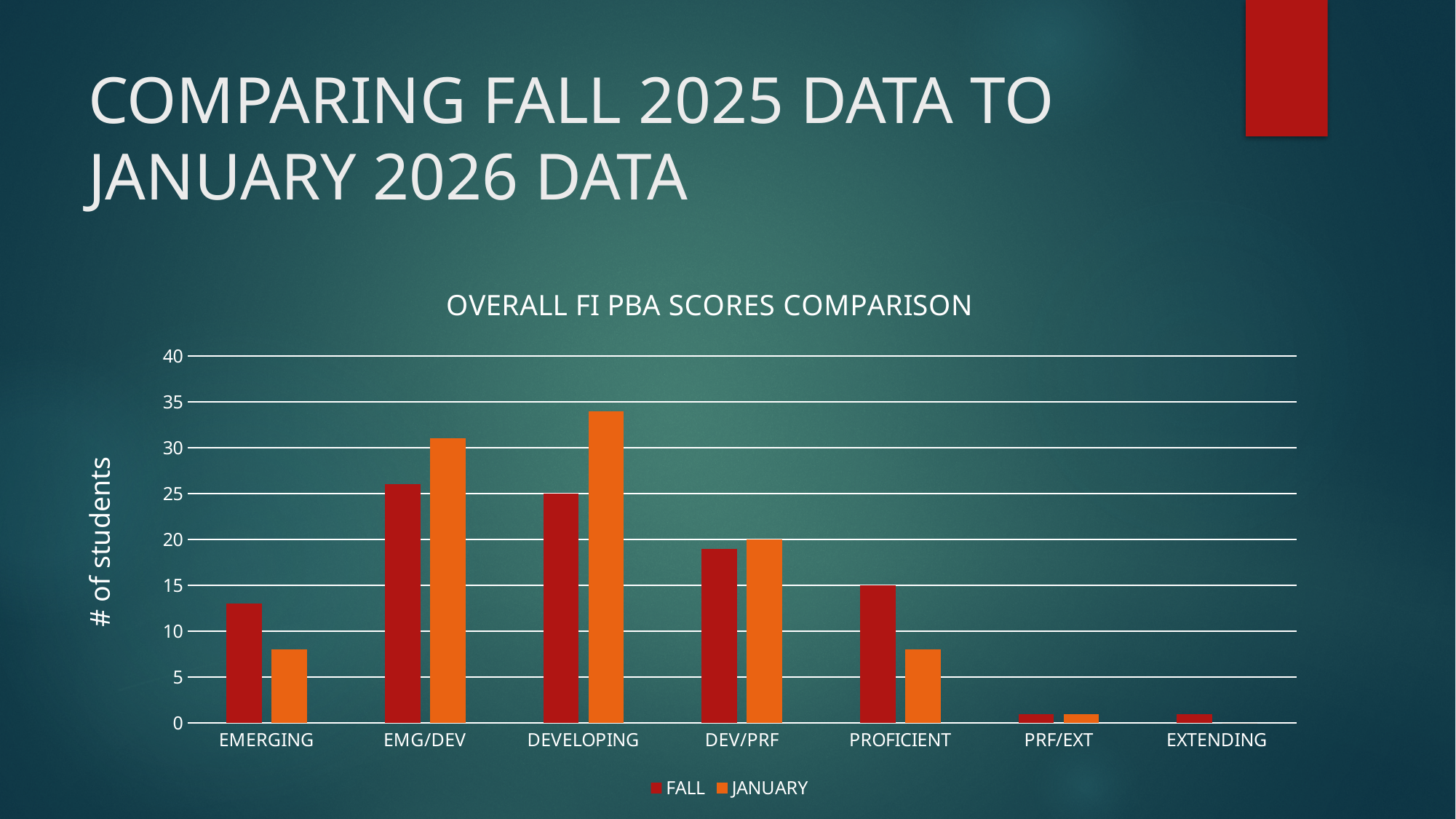
Is the FALL value for EMERGING greater or less than 10? greater What kind of chart is shown on the slide? bar chart For EMG/DEV, which series has the larger value, FALL or JANUARY? JANUARY What is the title of the chart? OVERALL FI PBA SCORES COMPARISON For PROFICIENT, which series has the larger value, FALL or JANUARY? FALL Which category has the highest JANUARY value? DEVELOPING Is the JANUARY value for EMG/DEV greater or less than 30? greater How many categories are shown on the x axis? 7 What is the label on the vertical axis? # of students How many series does the legend list? 2 Is the JANUARY value for EMERGING greater or less than 10? less Which category has the highest FALL value? EMG/DEV